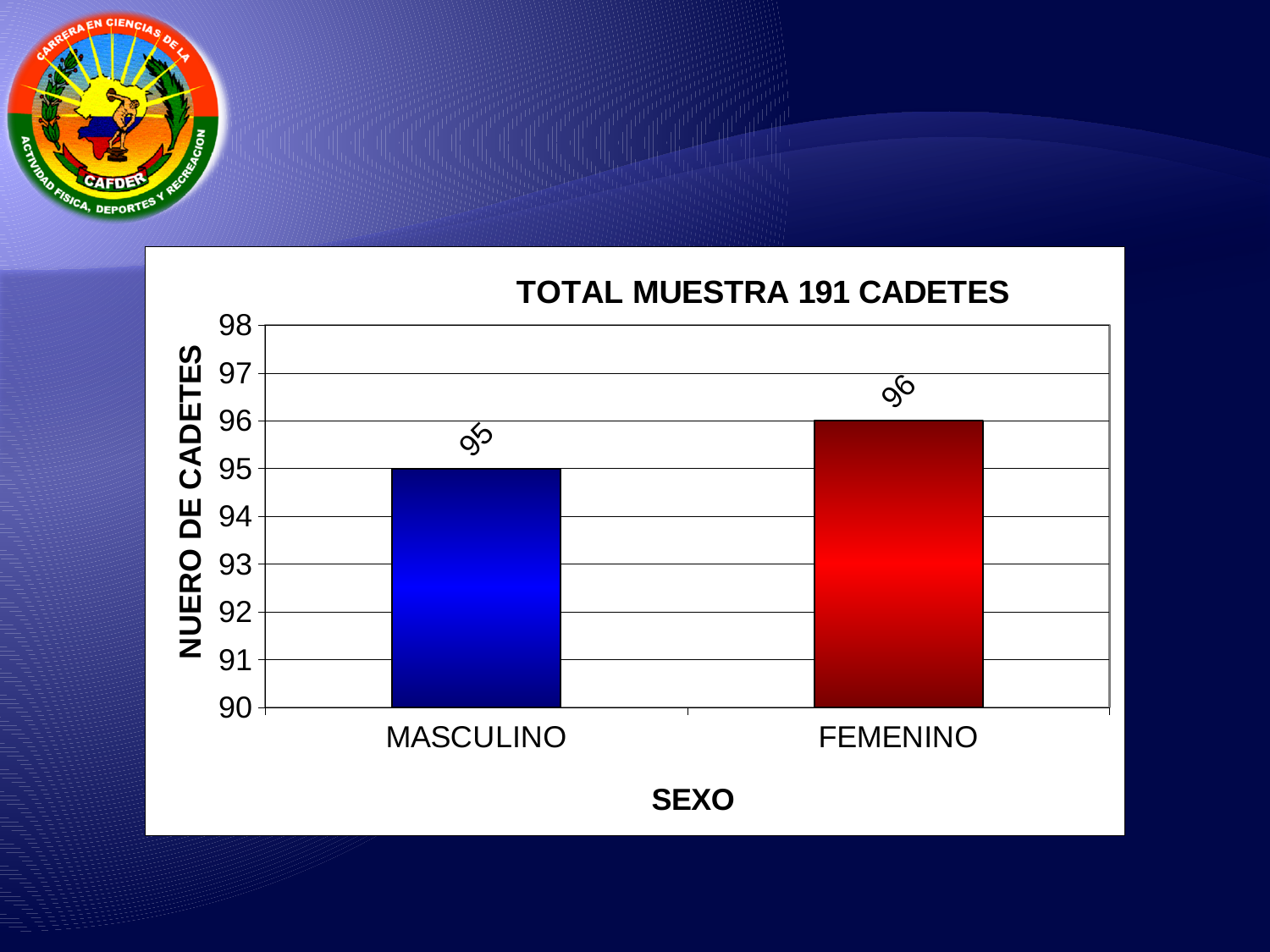
What is the difference between the values for FEMENINO and MASCULINO? 1 What kind of chart is shown on the slide? bar chart Which is larger, the value for MASCULINO or the value for FEMENINO? FEMENINO Is the value for FEMENINO greater or less than 97? less Is the value for MASCULINO greater or less than 94? greater What is the title of the chart? TOTAL MUESTRA 191 CADETES What is the label of the x axis? SEXO How many categories are shown on the x axis? 2 What is the value for FEMENINO? 96 Which category has the highest value? FEMENINO What is the value for MASCULINO? 95 Which category has the lowest value? MASCULINO